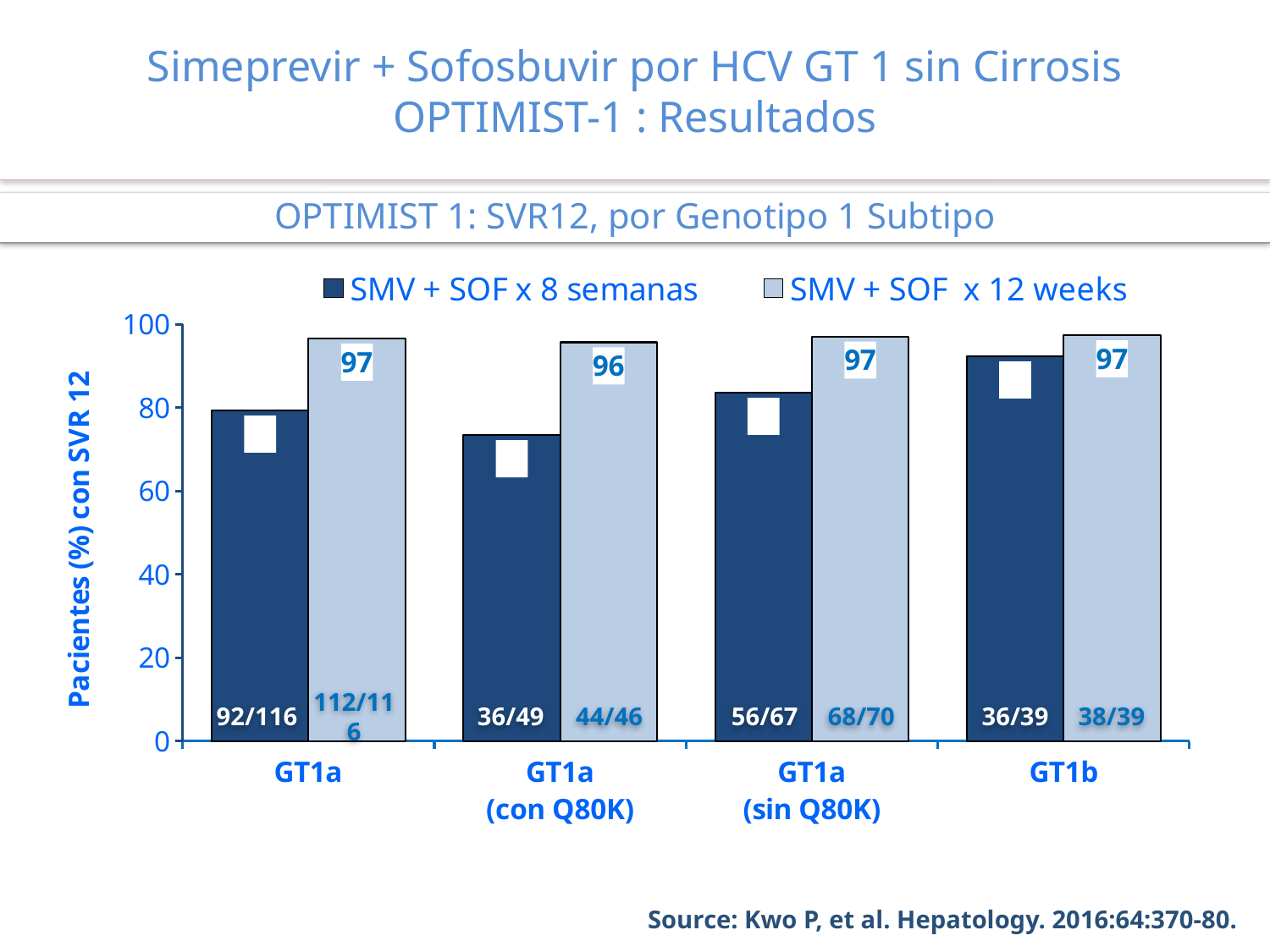
Is the SMV + SOF x 8 semanas value for GT1b greater or less than 80? greater What is the title of the y axis? Pacientes (%) con SVR 12 In the GT1a group, which series has the larger SVR12 value, SMV + SOF x 8 semanas or SMV + SOF x 12 weeks? SMV + SOF x 12 weeks Is the SMV + SOF x 8 semanas value for GT1a (con Q80K) greater or less than 60? greater What kind of chart is shown on the slide? bar chart What fraction of patients is printed on the SMV + SOF x 12 weeks bar for GT1b? 38/39 How many series does the legend list? 2 What is the SVR12 value for the SMV + SOF x 12 weeks series in the GT1b group? 97 What is the SVR12 value for the SMV + SOF x 12 weeks series in the GT1a (con Q80K) group? 96 How many genotype subgroups are shown on the x axis? 4 What fraction of patients is printed on the SMV + SOF x 8 semanas bar for GT1a (sin Q80K)? 56/67 Which group has the lowest SVR12 value for the SMV + SOF x 12 weeks series? GT1a (con Q80K)